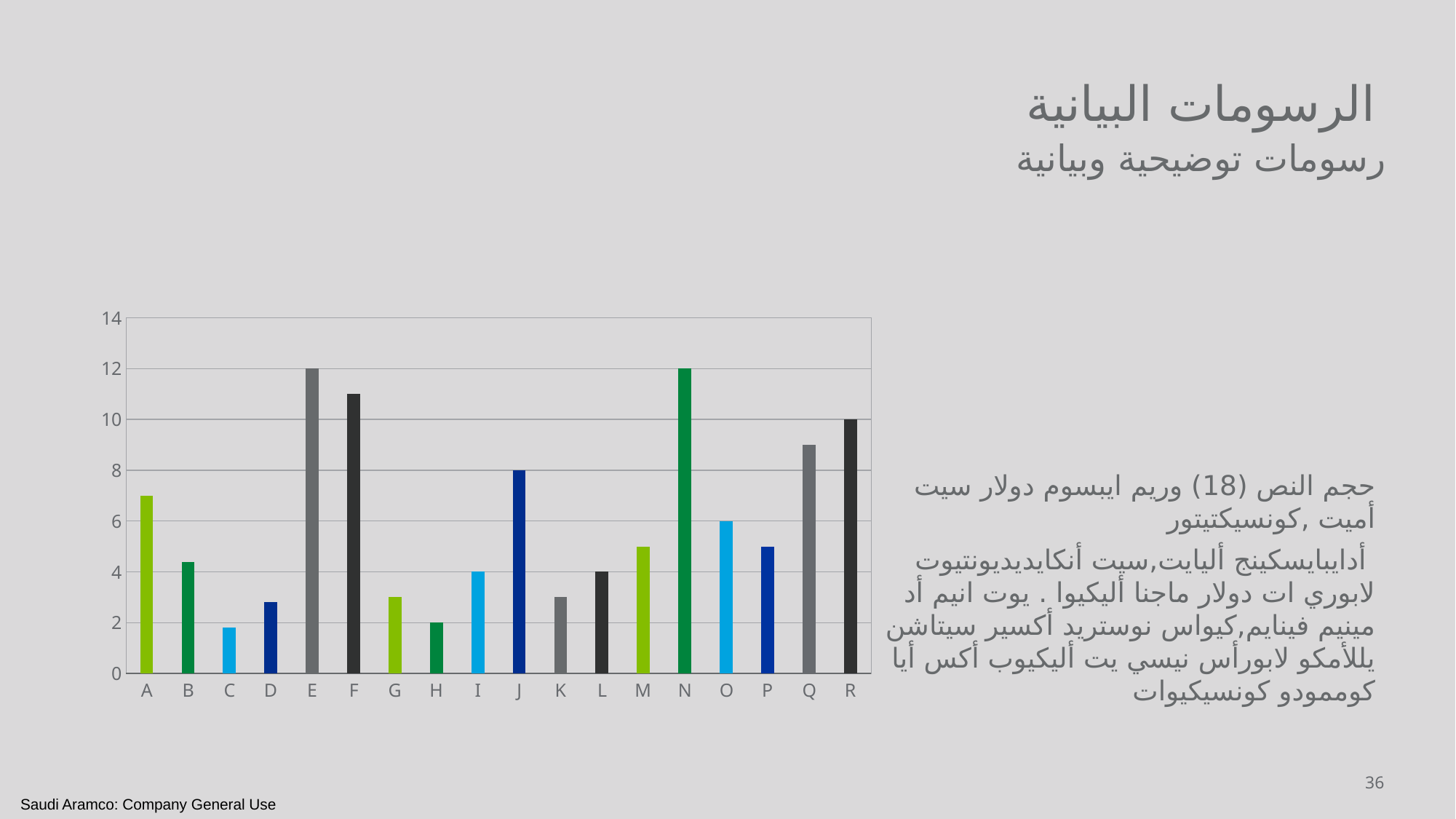
What is the value for category O? 6 Is the value for Q greater or less than 10? less What is the difference between the values for E and H? 10 Is the value for A greater or less than 6? greater Which is larger, the value for E or the value for A? E What is the value for category E? 12 What is the value for category R? 10 Which is larger, the value for K or the value for J? J What is the value for category J? 8 Is the value for F greater or less than 10? greater What kind of chart is shown on the slide? bar chart How many categories are plotted on the x axis of the chart? 18